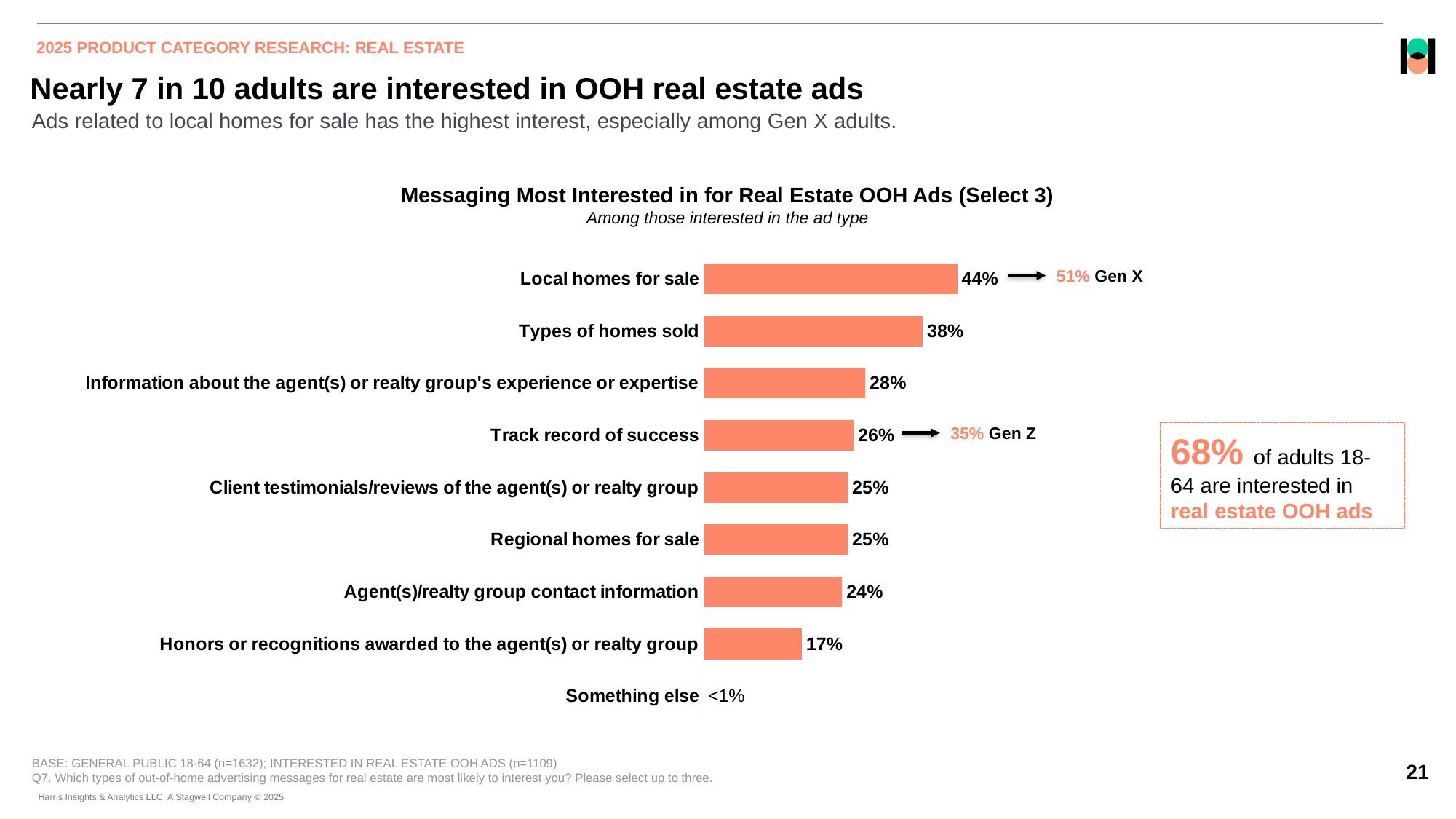
What value is shown for Something else? <1% What percentage is shown for Honors or recognitions awarded to the agent(s) or realty group? 17% What percentage is shown for Types of homes sold? 38% Which messaging category has the lowest percentage? Something else What kind of chart is shown on the slide? Bar chart What percentage is shown for Local homes for sale? 44% What is the title of the chart? Messaging Most Interested in for Real Estate OOH Ads (Select 3) Which is larger: Track record of success or Agent(s)/realty group contact information? Track record of success How many messaging categories are plotted in the chart? 9 What percentage of Gen X is called out for Local homes for sale? 51% What is the difference in percentage points between Local homes for sale and Types of homes sold? 6 Which messaging category has the highest percentage? Local homes for sale